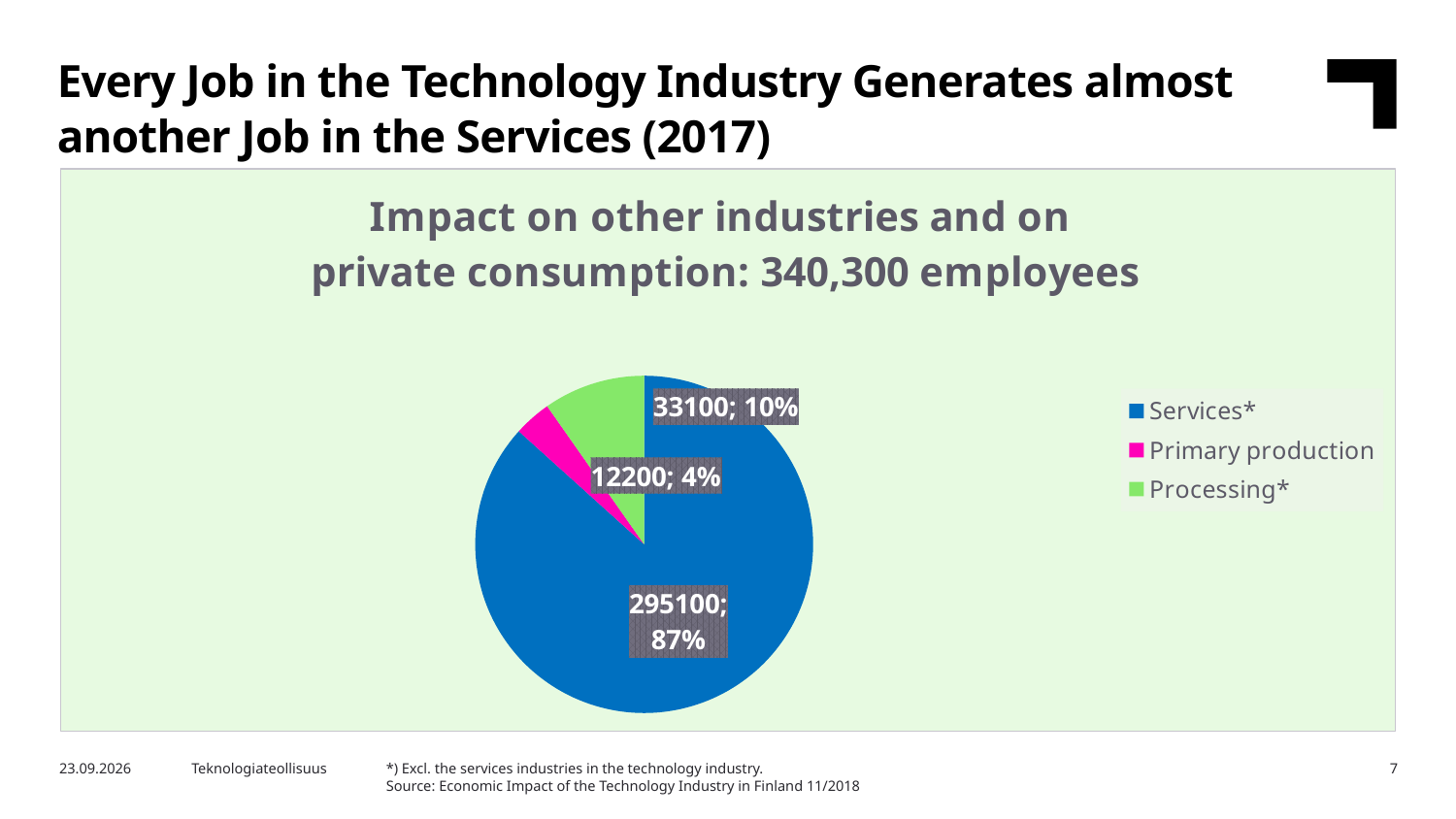
What percentage share does the Services* slice have? 87% Which category has the largest slice of the pie? Services* What is the difference in employees between Processing* and Primary production? 20900 What kind of chart is shown on the slide? pie chart How many employees does the Primary production slice represent? 12200 How many employees does the Services* slice represent? 295100 Which category has the smallest slice of the pie? Primary production How many categories does the legend list? 3 What colour is the Primary production slice? pink What percentage share does the Processing* slice have? 10% What is the title shown above the pie chart? Impact on other industries and on private consumption: 340,300 employees Which is larger, the Processing* slice or the Primary production slice? Processing*